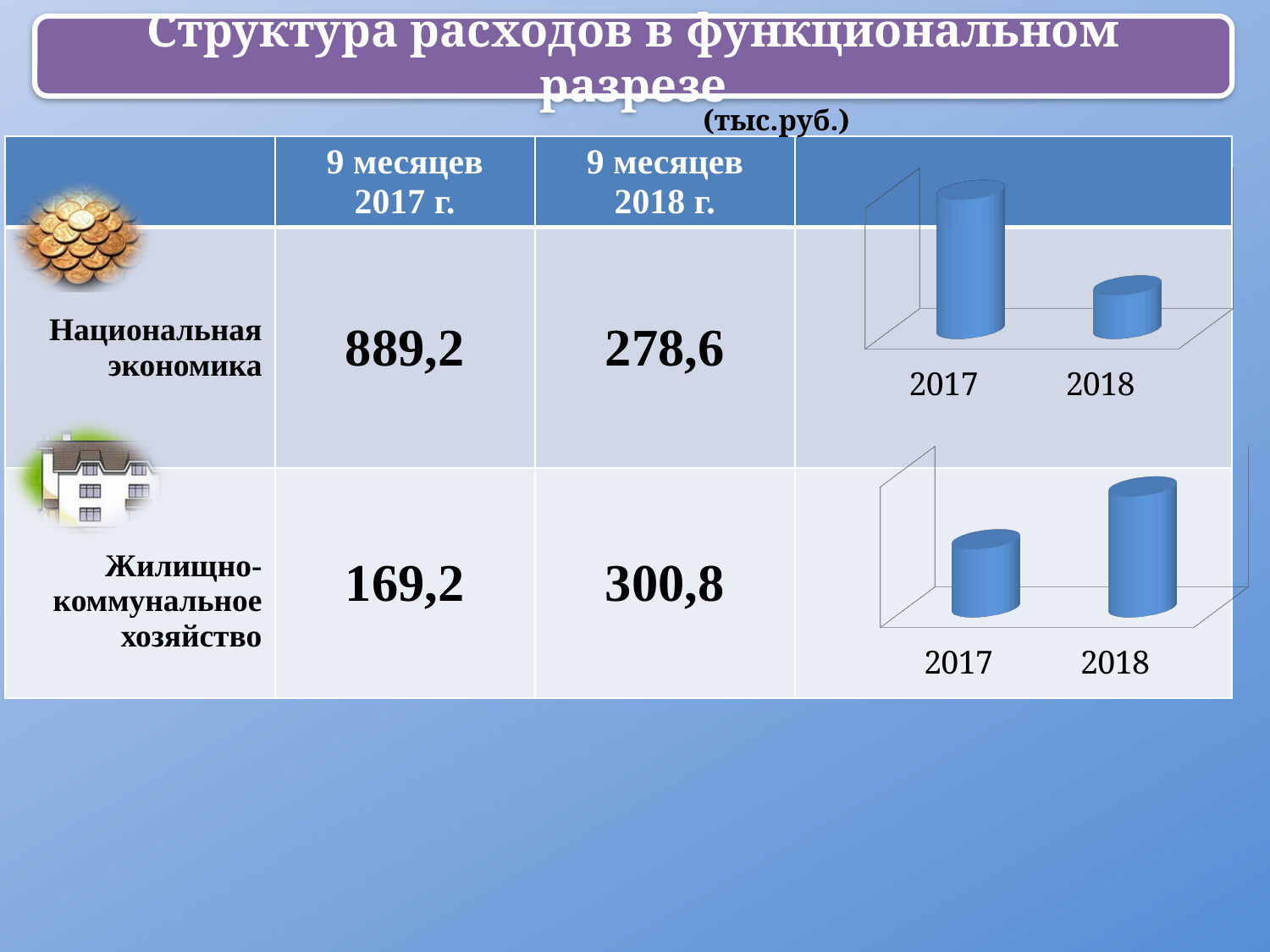
In the top chart (Национальная экономика), do the values rise or fall from 2017 to 2018? fall In the top chart (Национальная экономика), how many bars are plotted? 2 Which is larger: Жилищно-коммунальное хозяйство for 9 months of 2018 or Национальная экономика for 9 months of 2018? Жилищно-коммунальное хозяйство (300,8) In the bottom chart (Жилищно-коммунальное хозяйство), which year has the shorter bar? 2017 In the top chart (Национальная экономика), which year has the taller bar? 2017 According to the slide, what is the value for Национальная экономика for 9 months of 2018 (тыс.руб.)? 278,6 By how much did Национальная экономика decrease from 9 months of 2017 (889,2) to 9 months of 2018 (278,6)? 610,6 By how much did Жилищно-коммунальное хозяйство increase from 9 months of 2017 (169,2) to 9 months of 2018 (300,8)? 131,6 According to the slide, what is the value for Жилищно-коммунальное хозяйство for 9 months of 2017 (тыс.руб.)? 169,2 In the bottom chart (Жилищно-коммунальное хозяйство), do the values rise or fall from 2017 to 2018? rise In the bottom chart (Жилищно-коммунальное хозяйство), what are the category labels on the x axis? 2017, 2018 What kind of chart is shown next to the row 'Национальная экономика'? bar chart